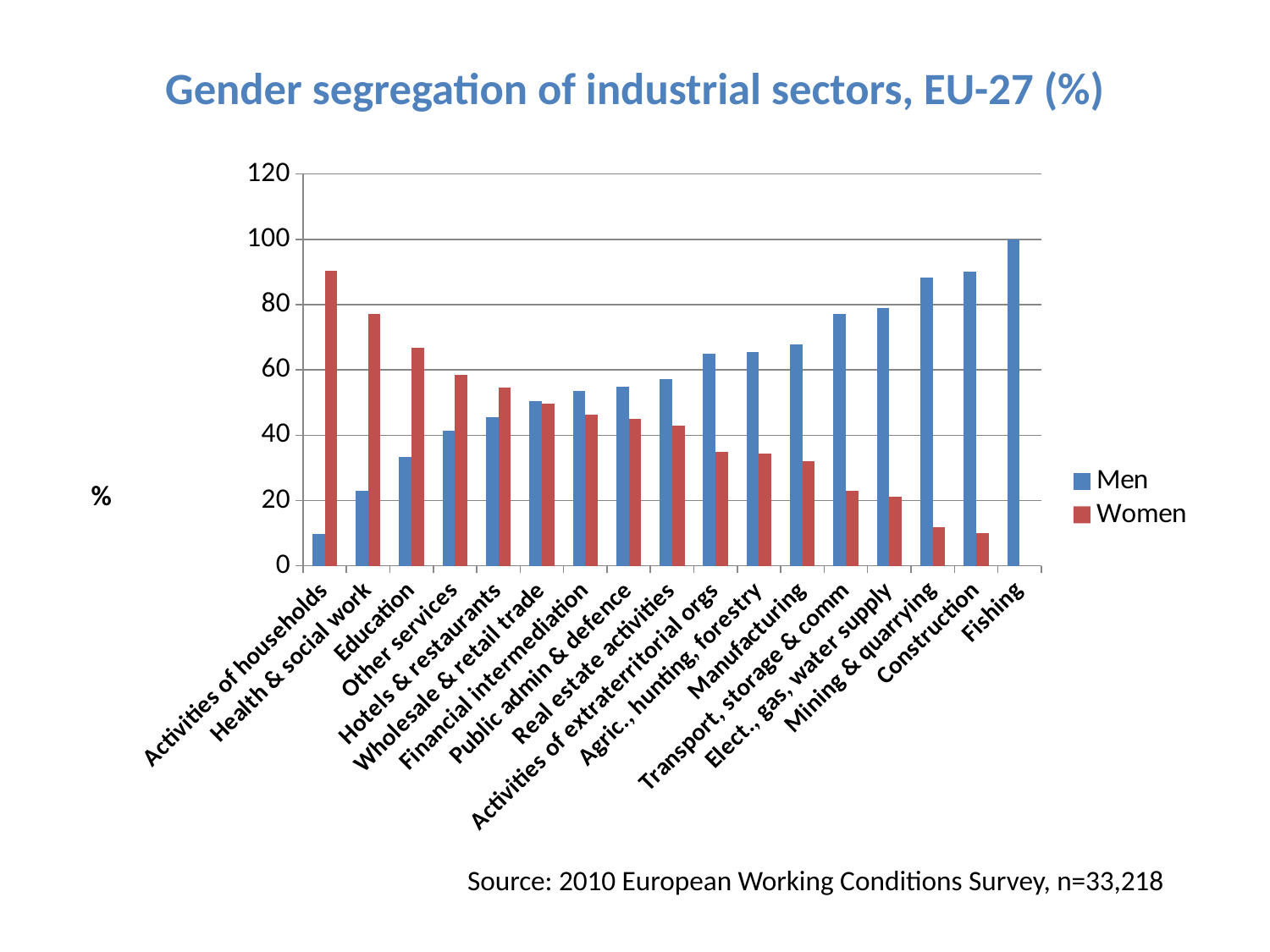
Is the value for Men in Construction greater or less than 80? greater Do the values for Men generally rise or fall moving left to right along the x axis? rise Is the value for Men in Education greater or less than 40? less Is the value for Women in Health & social work greater or less than 60? greater What kind of chart is shown on the slide? Bar chart Which sector has the highest value for Men? Fishing How many series does the legend list? 2 How many industrial sectors are shown on the x axis? 17 What is the value for Men in Fishing? 100 Which sector has the lowest value for Men? Activities of households In Hotels & restaurants, which is larger, the value for Men or for Women? Women Which sector has the highest value for Women? Activities of households